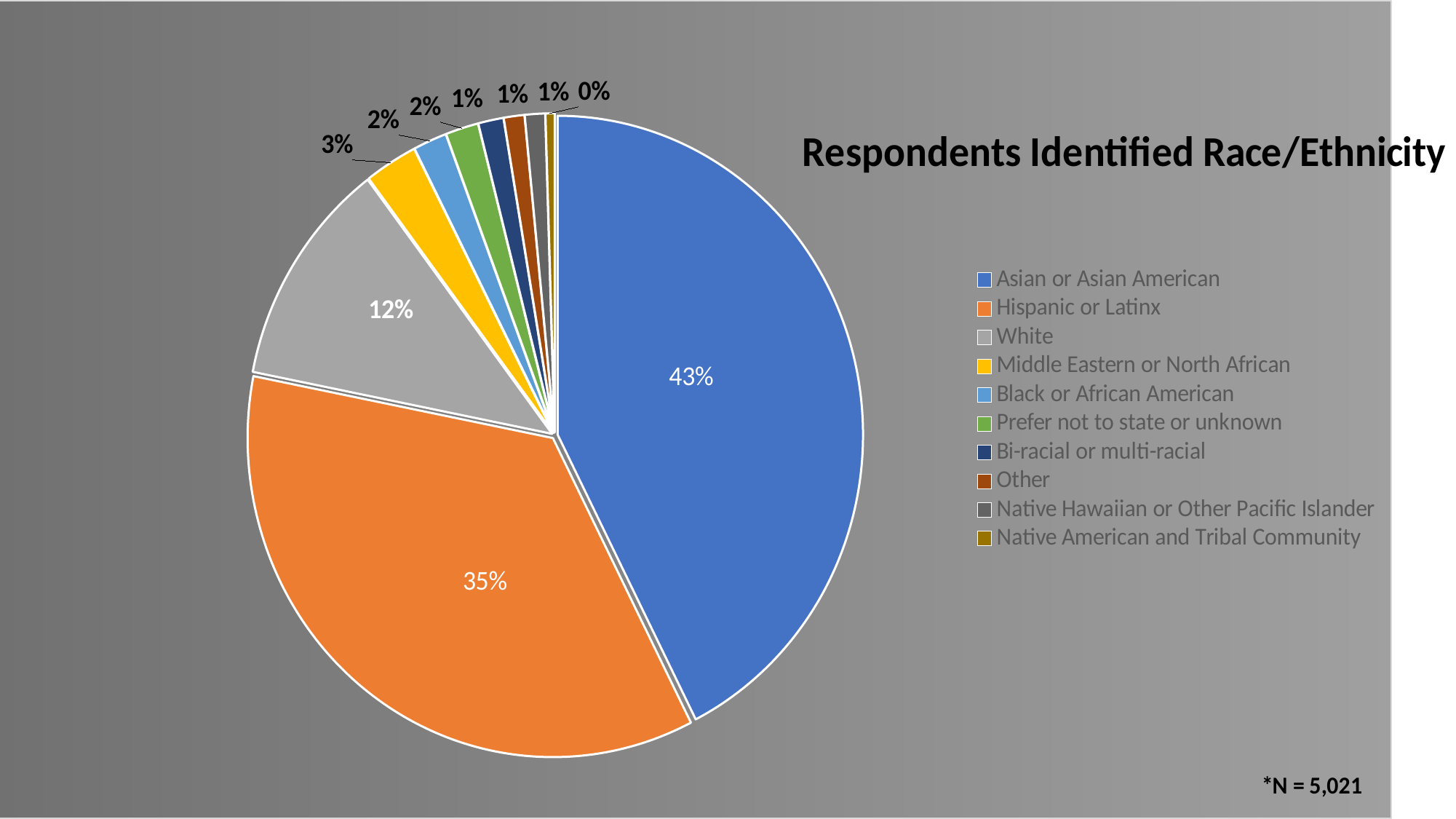
What share of respondents identified as Hispanic or Latinx? 35% What type of chart is shown on the slide? Pie chart Which race/ethnicity category has the smallest share of respondents? Native American and Tribal Community What share of respondents identified as White? 12% What is the title of the chart? Respondents Identified Race/Ethnicity What share of respondents identified as Native American and Tribal Community? 0% How many race/ethnicity categories does the legend list? 10 Which is larger: the share for White or the share for Middle Eastern or North African? White Which race/ethnicity category has the largest share of respondents? Asian or Asian American What is the difference in percentage points between the Asian or Asian American share and the Hispanic or Latinx share? 8 percentage points